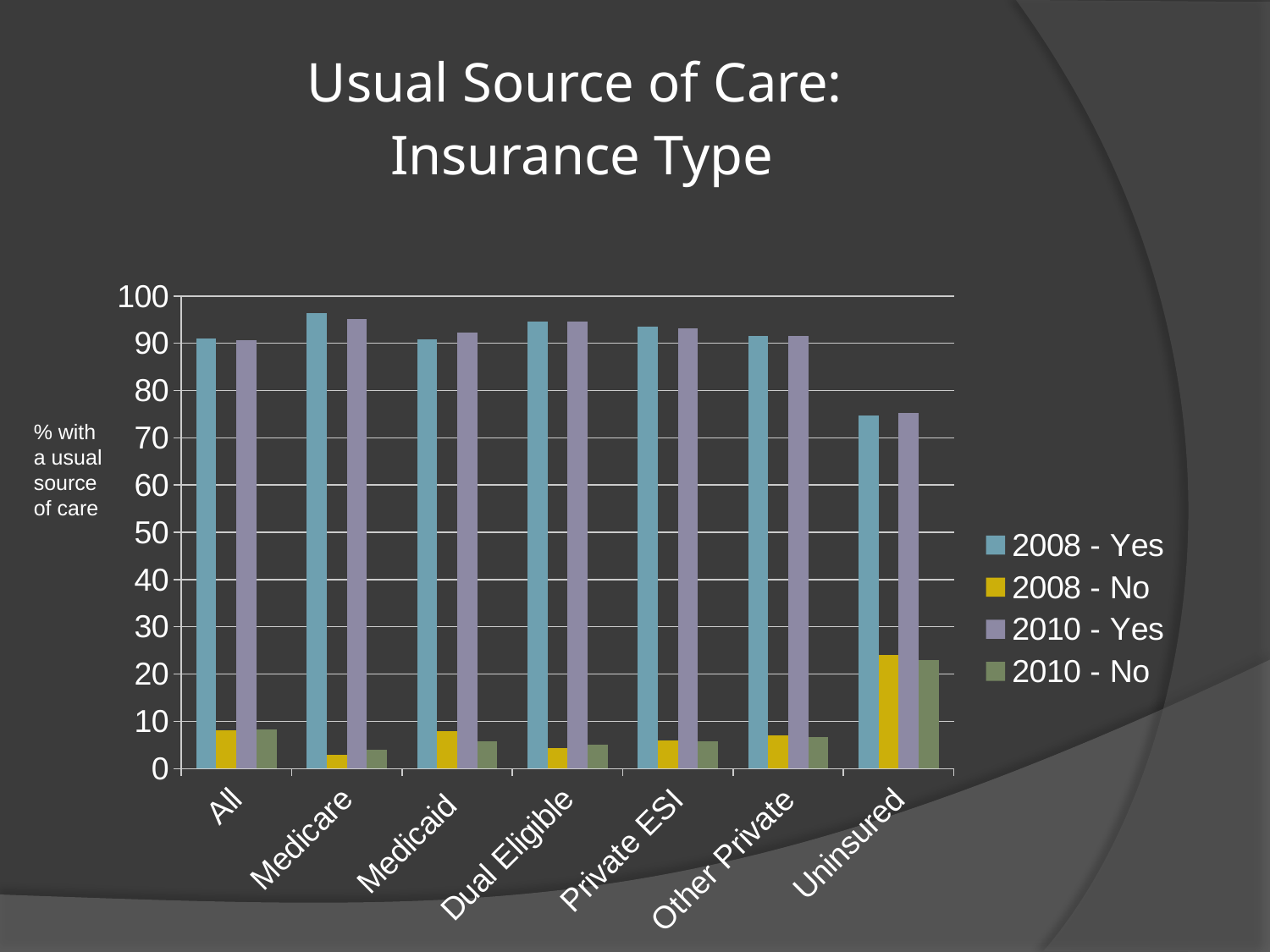
What kind of chart is shown on the slide? bar chart Which category has the highest value for the 2008 - No series? Uninsured Is the 2008 - Yes value for Uninsured greater or less than 80? less Which is larger, the 2008 - No value for Uninsured or the 2008 - No value for All? Uninsured Which category has the lowest value for the 2008 - Yes series? Uninsured How many series does the legend list? 4 What does the y axis of the chart measure? % with a usual source of care Is the 2010 - Yes value for Medicare greater or less than 90? greater Which category has the highest value for the 2008 - Yes series? Medicare How many insurance type categories are shown on the x axis? 7 Is the 2008 - No value for Uninsured greater or less than 20? greater Which category has the highest value for the 2010 - No series? Uninsured